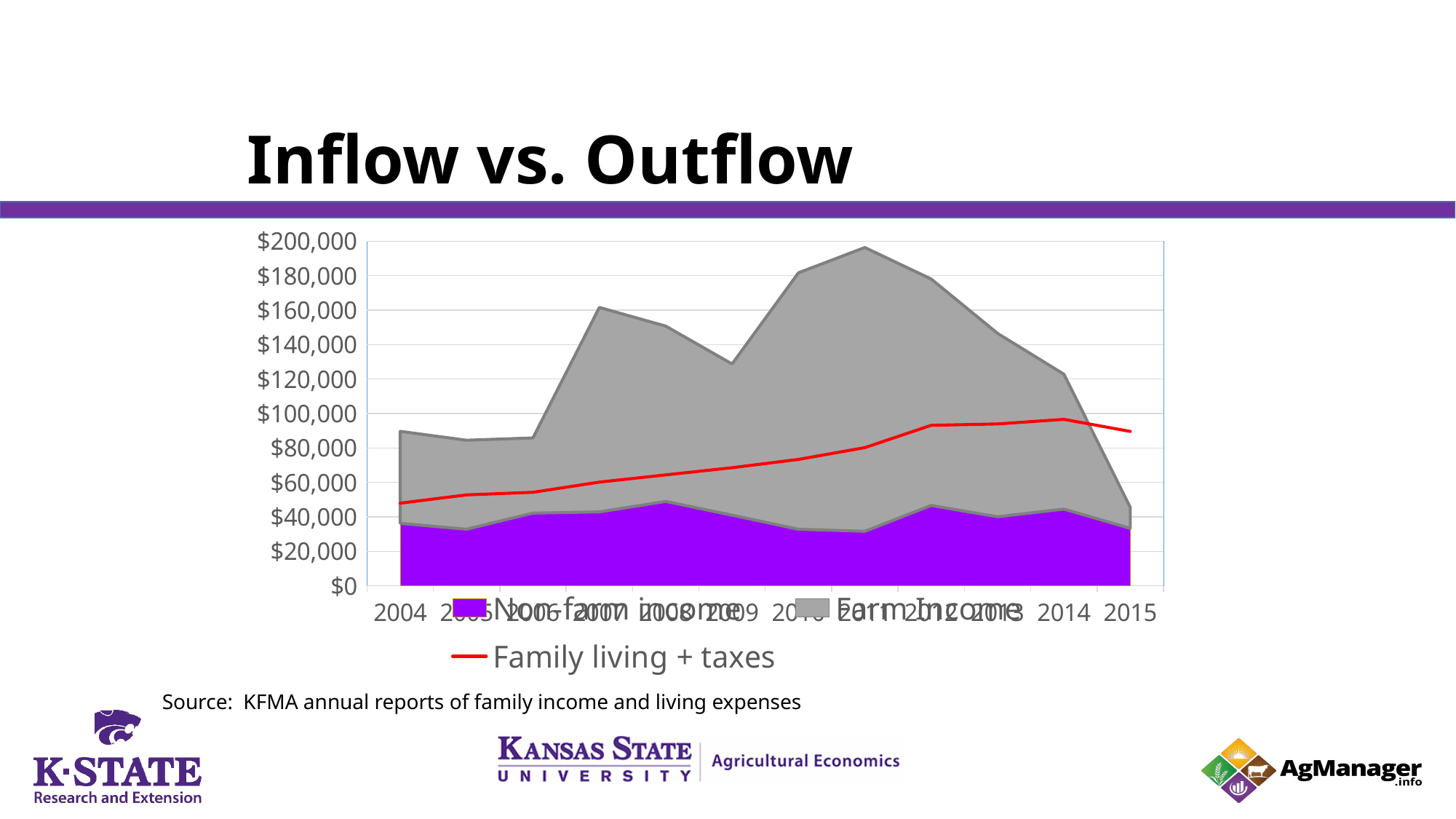
Which series is drawn as a red line in the chart? Family living + taxes Does the Family living + taxes line rise or fall from 2004 to 2014? rise What is the title of the slide containing the chart? Inflow vs. Outflow Is the Family living + taxes value in 2014 greater or less than $80,000? greater In which year is the combined Non-farm income plus Farm Income lowest? 2015 In which year is the combined Non-farm income plus Farm Income highest? 2011 Which year has the larger combined Non-farm income plus Farm Income, 2007 or 2009? 2007 Is the Family living + taxes value in 2004 greater or less than $60,000? less Is the combined Non-farm income plus Farm Income in 2011 greater or less than $180,000? greater How many series does the chart's legend list? 3 How many years are shown on the x axis of the chart? 12 What kind of chart is shown on the slide? Stacked area chart with a line